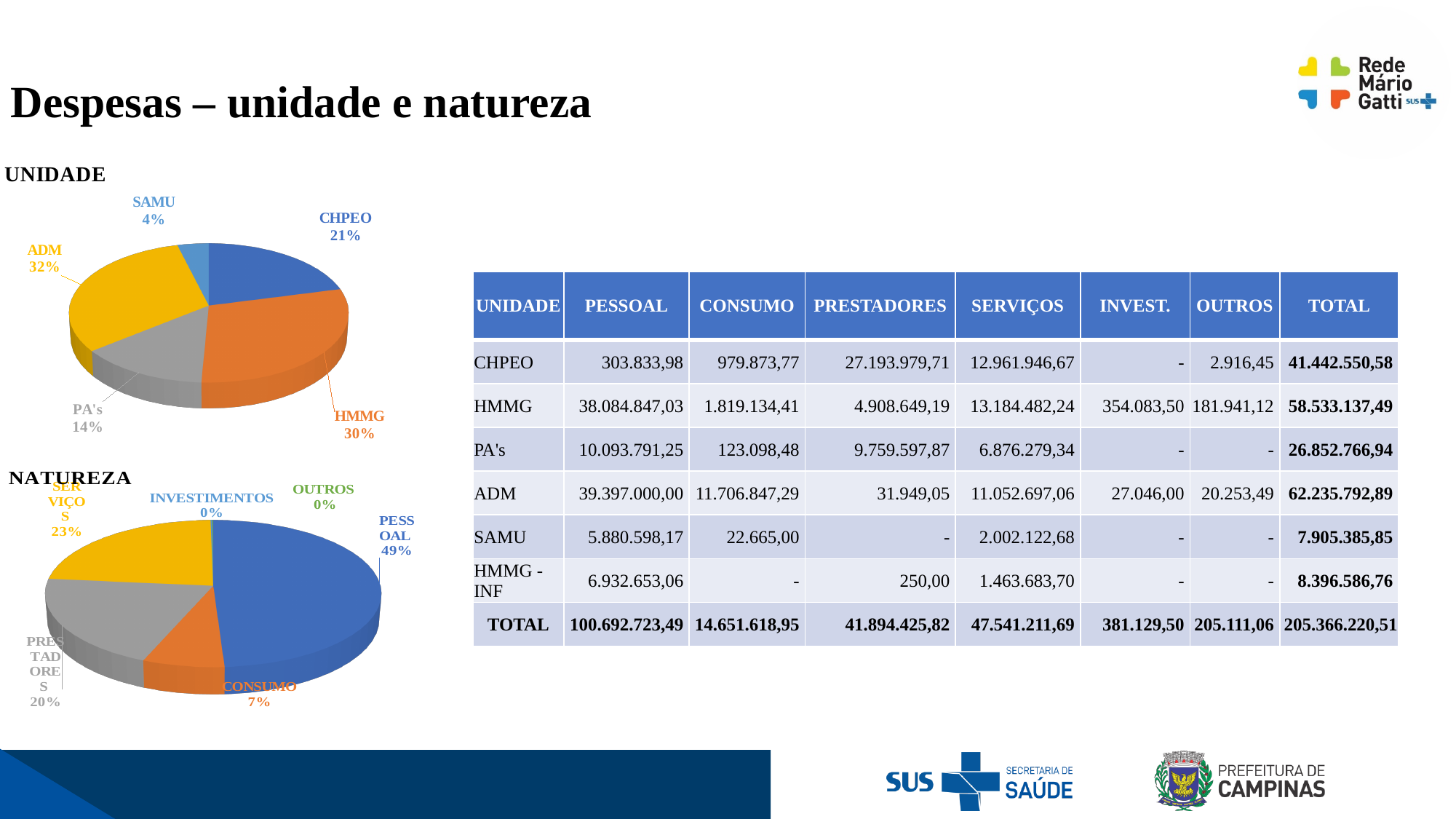
In the UNIDADE pie chart, which unit has the smallest share? SAMU What type of chart is used for the NATUREZA chart? Pie chart In the NATUREZA pie chart, which category has the largest share? PESSOAL In the NATUREZA pie chart, what percentage is shown for CONSUMO? 7% In the UNIDADE pie chart, which unit has the largest share? ADM In the UNIDADE pie chart, what is the difference in percentage points between CHPEO and PA's? 7 In the NATUREZA pie chart, which is larger, SERVIÇOS or PRESTADORES? SERVIÇOS In the UNIDADE pie chart, which is larger, the share of CHPEO or the share of PA's? CHPEO In the NATUREZA pie chart, how many categories are labelled? 6 In the UNIDADE pie chart, what percentage is shown for HMMG? 30% In the UNIDADE pie chart, what share does ADM have? 32% In the NATUREZA pie chart, what share does PESSOAL have? 49%